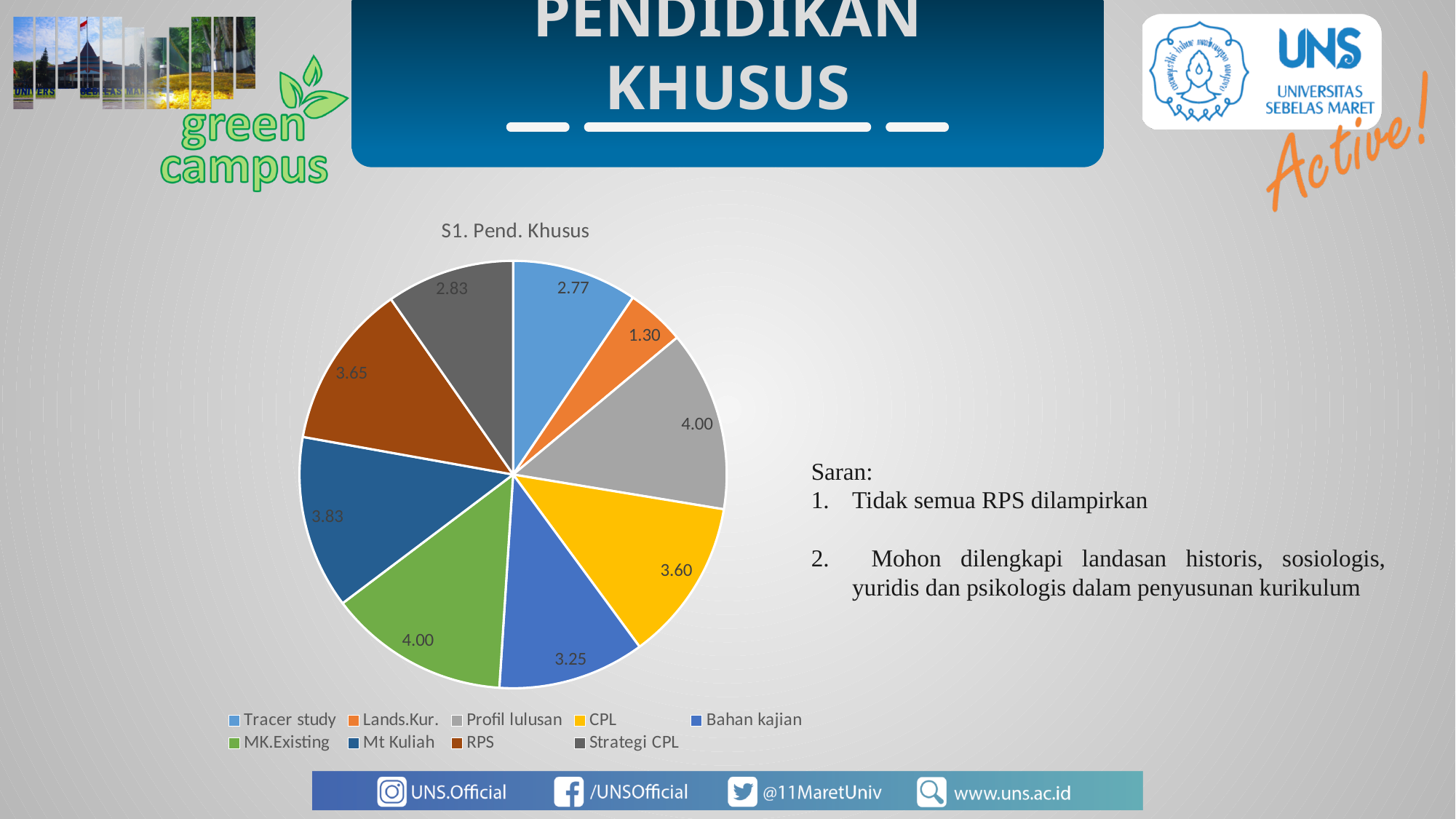
What is the value for Tracer study in the pie chart? 2.77 What is the title of the pie chart? S1. Pend. Khusus What colour is the RPS slice in the pie chart? brown How many categories does the pie chart have? 9 What is the value for Lands.Kur. in the pie chart? 1.30 Which is larger, the value for CPL or the value for Bahan kajian? CPL Which category has the lowest value in the pie chart? Lands.Kur. What is the value for Mt Kuliah in the pie chart? 3.83 Which two categories share the highest value in the pie chart? Profil lulusan and MK.Existing What is the difference between the values for Mt Kuliah and Bahan kajian? 0.58 What kind of chart is shown on the slide? pie chart What is the value for Strategi CPL in the pie chart? 2.83